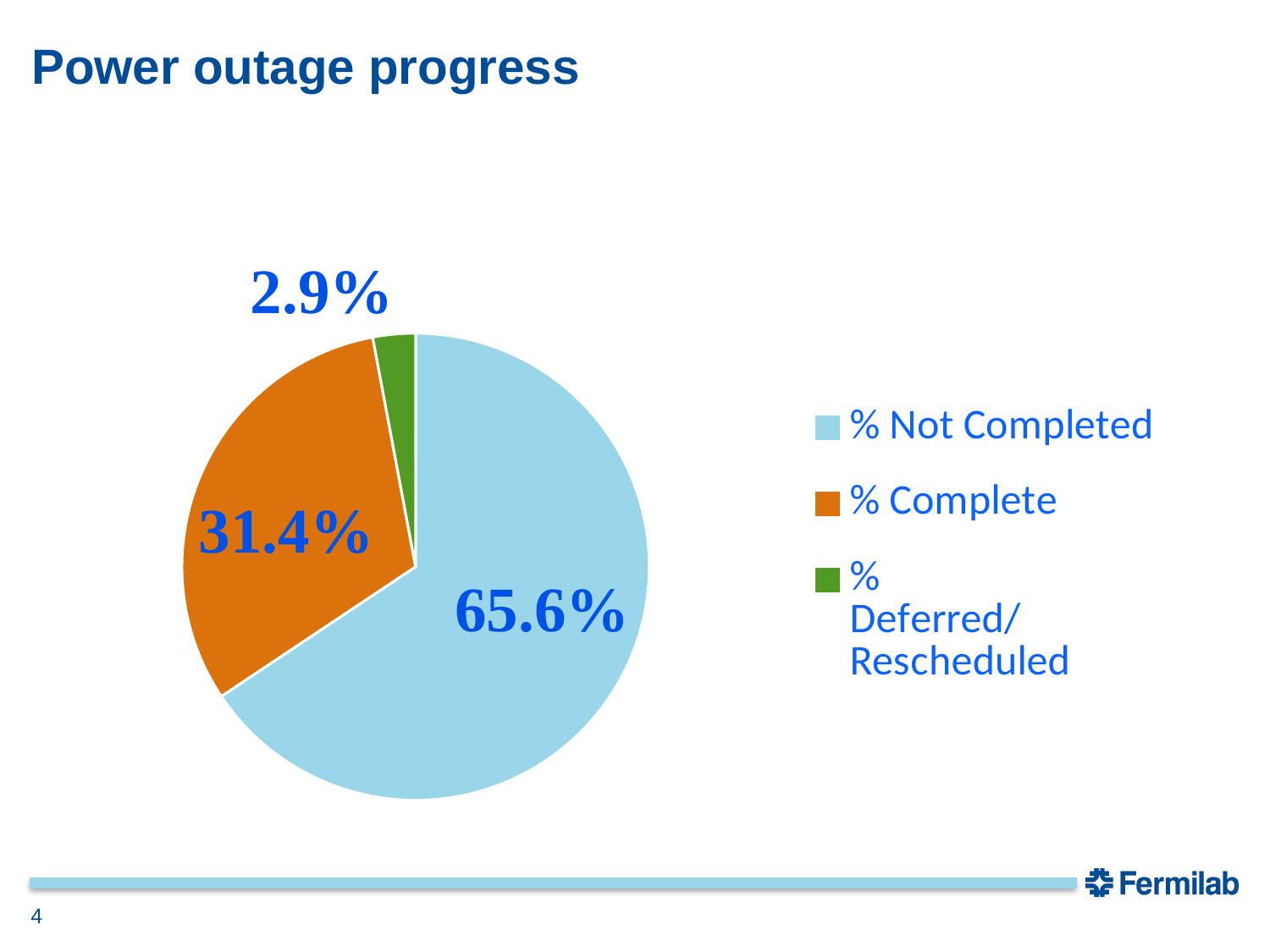
What colour is the % Complete slice? orange What kind of chart is shown on the slide? pie chart What is the value for % Complete? 31.4% How many slices does the pie chart have? 3 Which is larger, % Complete or % Deferred/Rescheduled? % Complete What is the difference between the % Not Completed and % Complete values? 34.2% What is the value for % Not Completed? 65.6% How many entries does the legend list? 3 Which category has the smallest slice of the pie? % Deferred/Rescheduled What is the value for % Deferred/Rescheduled? 2.9% Which category has the largest slice of the pie? % Not Completed What is the difference between the % Complete and % Deferred/Rescheduled values? 28.5%